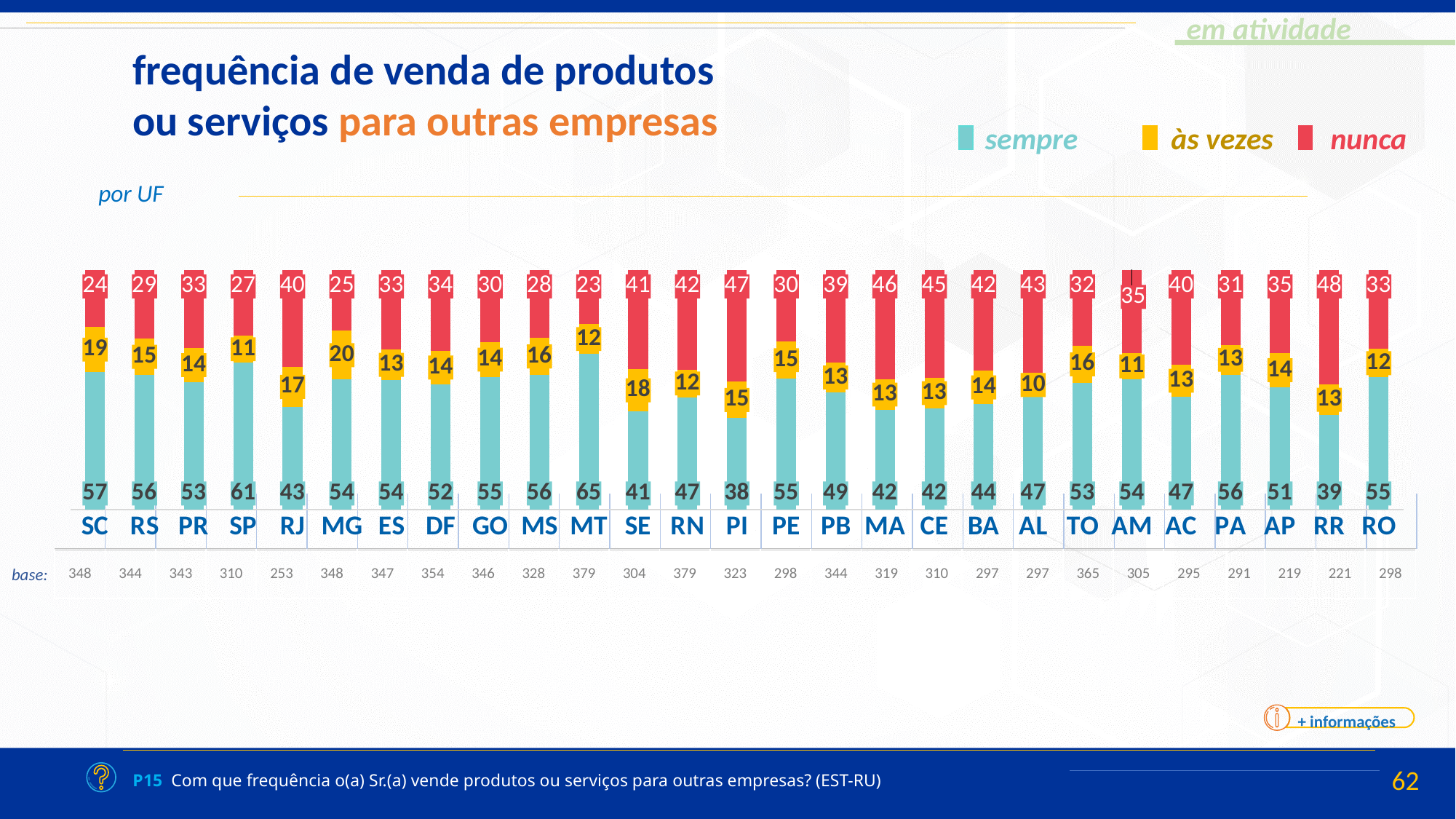
What is the 'nunca' value for RR? 48 How many series does the legend list? 3 Which UF has the highest 'sempre' value? MT Which is larger, the 'sempre' value for SP or the 'sempre' value for RJ? SP Which UF has the lowest 'sempre' value? PI What is the difference between the 'nunca' values for PI and SC? 23 What is the 'sempre' value for MT? 65 How many UF categories are plotted along the x axis? 27 What is the total of the stacked bar for SE? 100 Which UF has the lowest 'às vezes' value? AL What type of chart is shown on the slide? stacked bar chart What is the 'às vezes' value for MG? 20